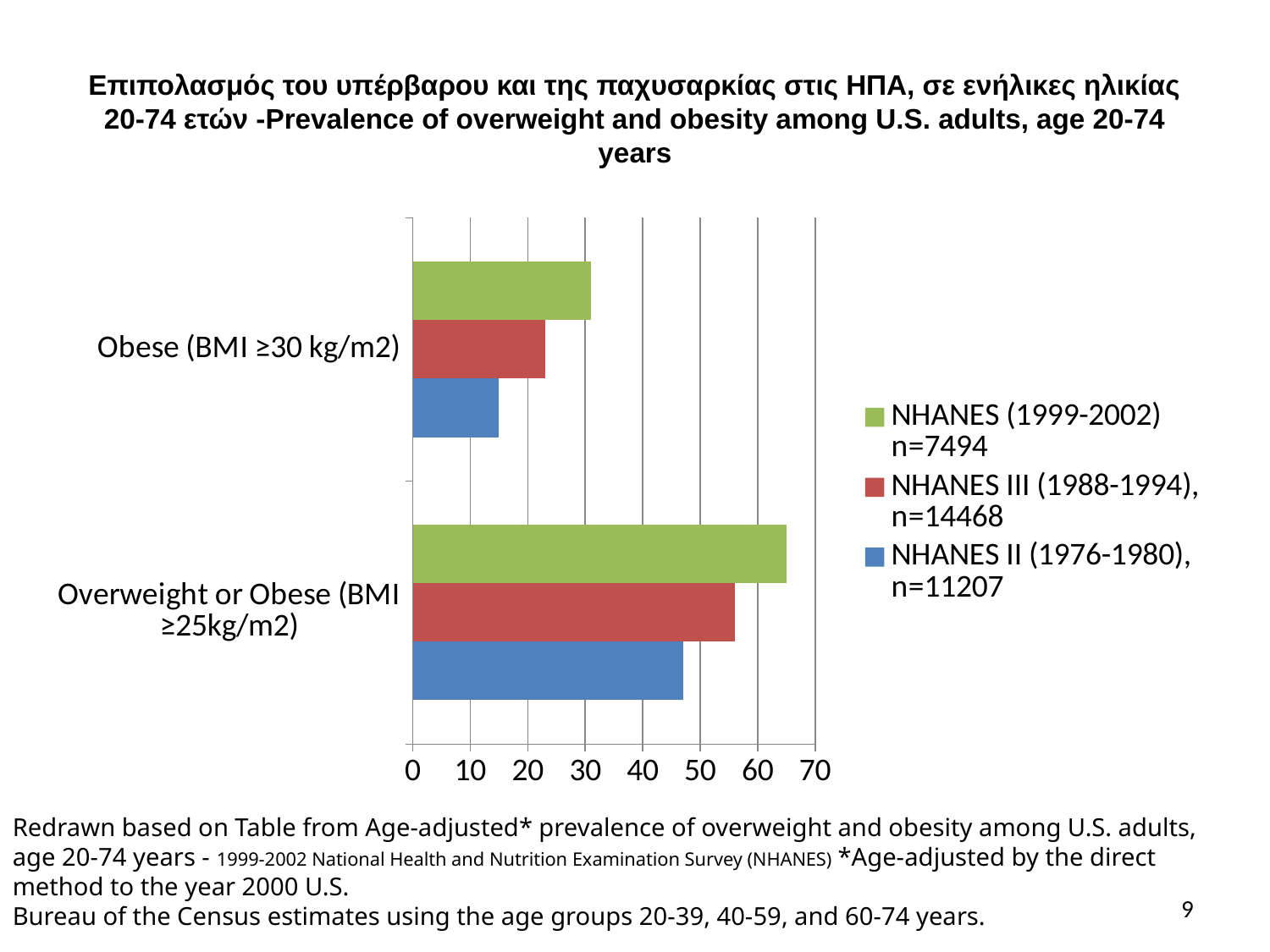
What kind of chart is shown on the slide? bar chart Which series has the highest value for Overweight or Obese (BMI ≥25kg/m2)? NHANES (1999-2002) n=7494 How many categories are shown on the chart? 2 Is the value for NHANES II (1976-1980) in the Obese category greater or less than 20? less Is the value for NHANES III (1988-1994) in the Obese category greater or less than 30? less What is the highest value shown on the horizontal axis of the chart? 70 For the Obese (BMI ≥30 kg/m2) category, which is larger: the NHANES (1999-2002) value or the NHANES II (1976-1980) value? NHANES (1999-2002) Is the value for NHANES (1999-2002) in the Overweight or Obese category greater or less than 60? greater How many series does the legend list? 3 Which series has the lowest value for Obese (BMI ≥30 kg/m2)? NHANES II (1976-1980), n=11207 Which colour represents NHANES III (1988-1994) in the chart? red